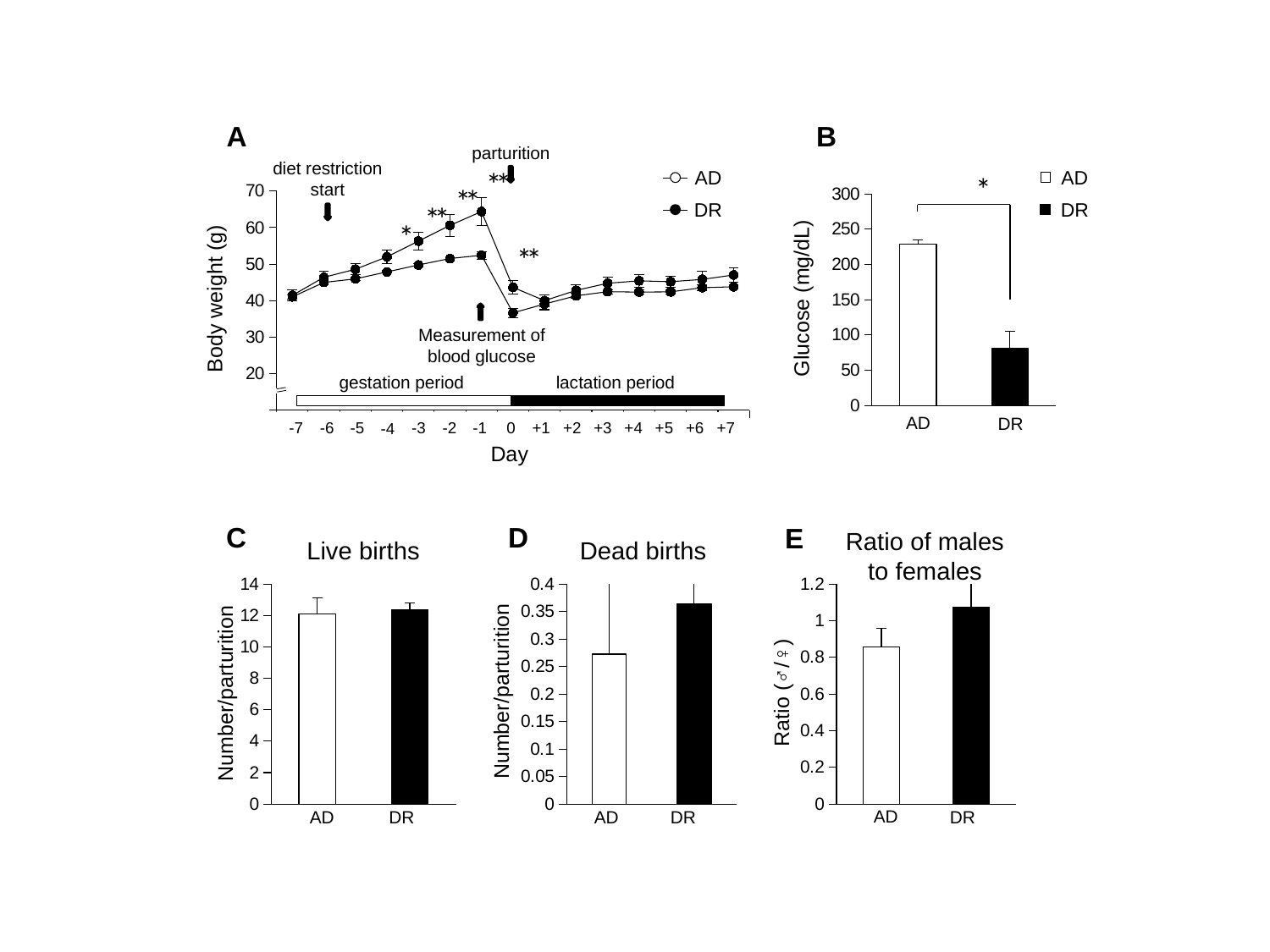
In chart C (Live births), is the value for AD greater or less than 10? greater In chart A, how many day points are shown on the x axis? 15 In chart D (Dead births), which group has the higher value, AD or DR? DR In chart E (Ratio of males to females), is the value for DR greater or less than 1? greater In chart A, is the DR body weight at day 0 greater or less than 40? less In chart A, which series has the higher body weight at day -1, AD or DR? AD How many series does the legend of chart A list? 2 What kind of chart is chart A (Body weight)? line chart In chart B (Glucose), which group has the higher glucose value? AD In chart A, does the AD body weight rise or fall from day -7 to day -1? rise